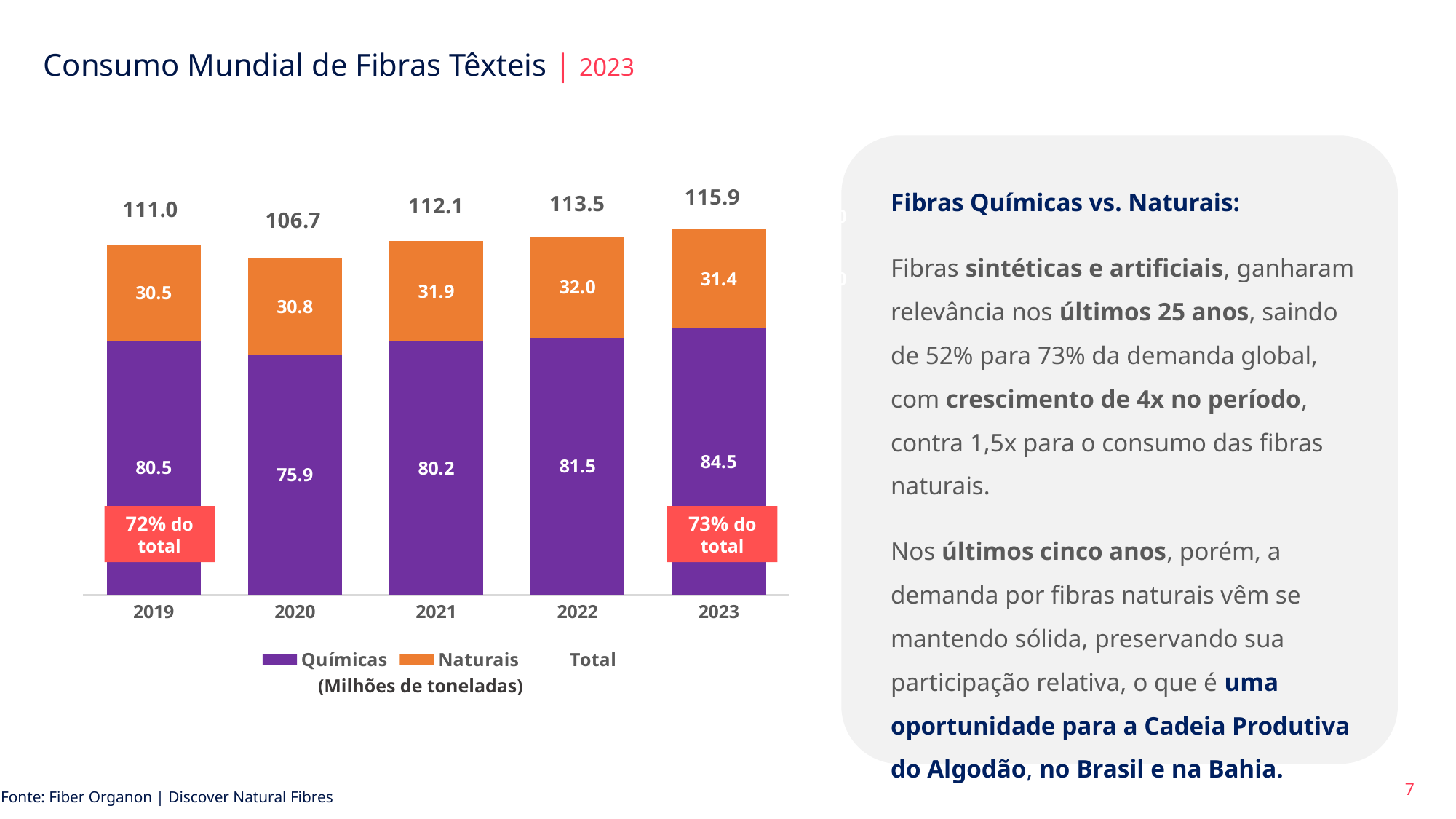
Which year has the lowest value for Químicas? 2020 What is the total consumption shown for 2021? 112.1 What is the value for Químicas in 2023? 84.5 What is the difference between the Químicas value in 2023 and in 2019? 4.0 Which year has the highest total consumption? 2023 What kind of chart is shown on the slide? Stacked bar chart How many years are shown on the x axis? 5 Is the Naturais value larger in 2022 or in 2019? 2022 Which year has the lowest total consumption? 2020 How many entries does the legend list? 3 Does the total consumption rise or fall from 2020 to 2023? Rise What is the value for Naturais in 2020? 30.8